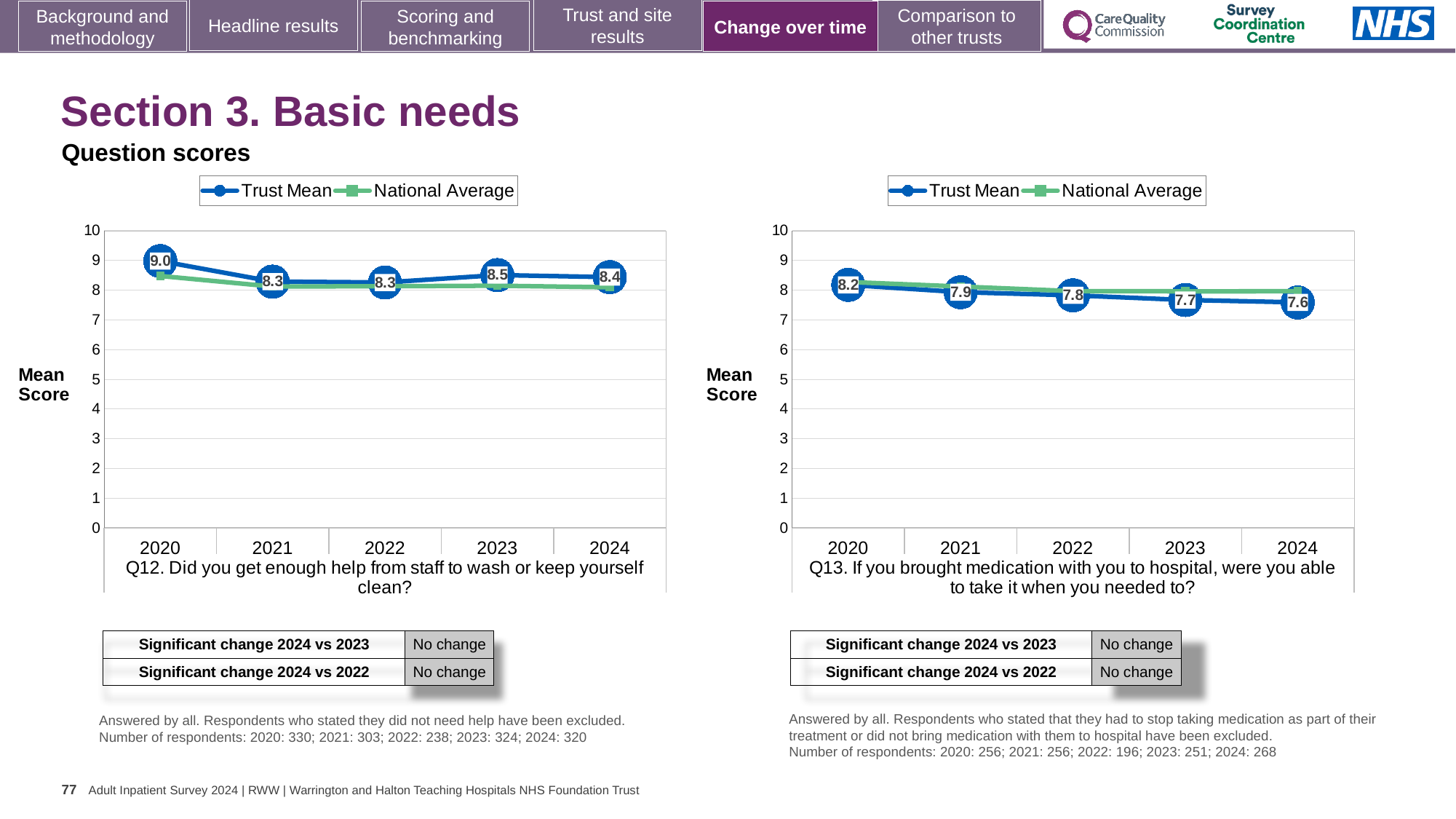
Which is larger: the Trust Mean for 2024 in the Q12 chart or the Trust Mean for 2024 in the Q13 chart? Q12 chart (8.4) In the Q13 chart (right), what is the Trust Mean for 2022? 7.8 In the Q12 chart (left), which year has the highest Trust Mean? 2020 In the Q13 chart (right), what is the difference between the Trust Mean in 2020 and in 2024? 0.6 How many series does the legend of the Q12 chart (left) list? 2 In the Q12 chart (left), what is the difference between the Trust Mean in 2020 and in 2021? 0.7 In the Q12 chart (left), what is the Trust Mean for 2024? 8.4 In the Q12 chart (left), is the Trust Mean for 2023 greater or less than 8? greater How many years are shown on the x axis of the Q13 chart (right)? 5 In the Q13 chart (right), does the Trust Mean rise or fall from 2020 to 2024? fall In the Q13 chart (right), which year has the lowest Trust Mean? 2024 In the Q12 chart (left), what is the Trust Mean for 2020? 9.0